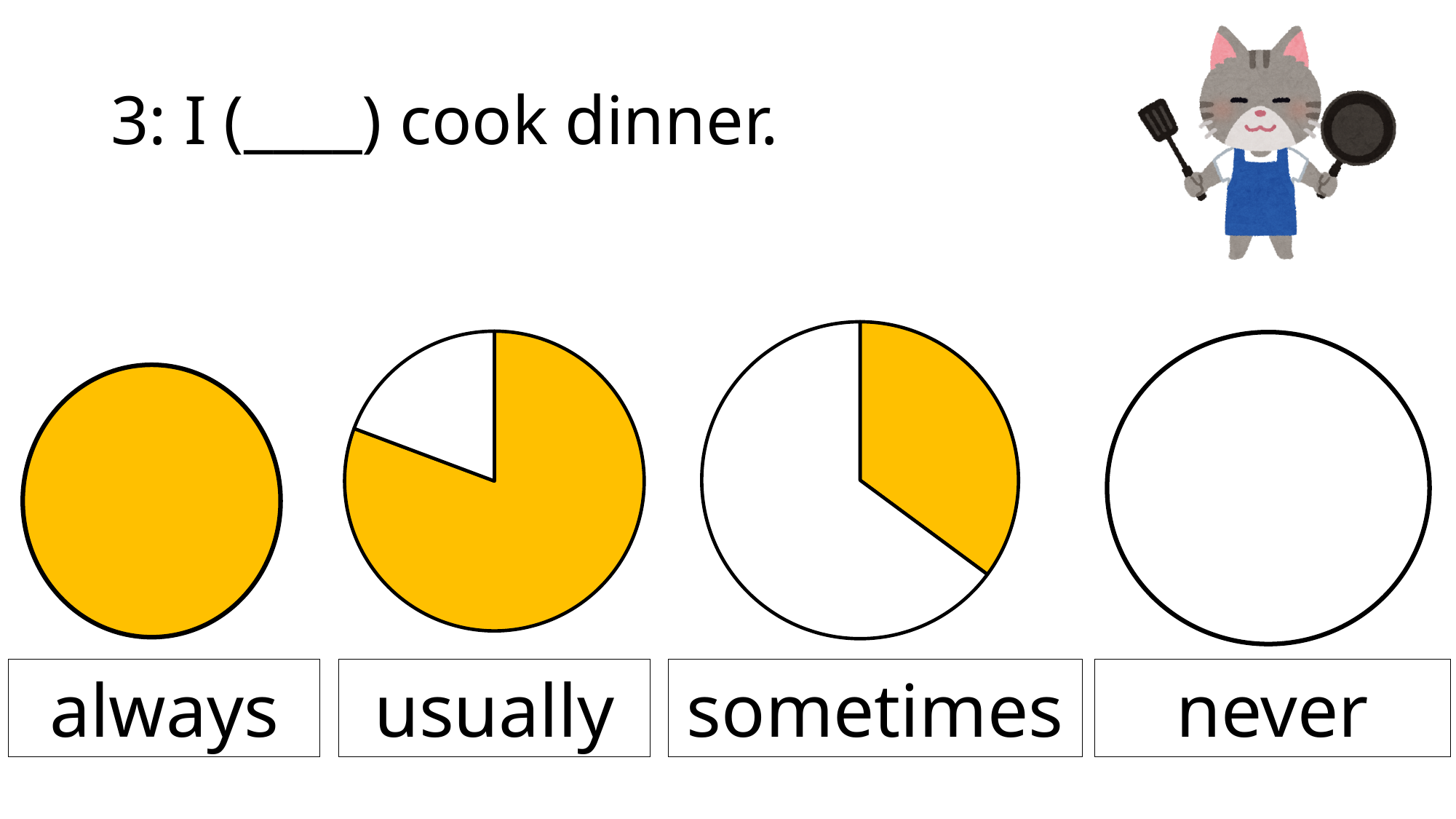
Which chart has a larger yellow share, sometimes or always? always Is the yellow portion of the 'sometimes' chart greater or less than half of the circle? less Which labelled chart has the largest yellow share? always How many pie charts are shown on the slide? 4 What kind of chart is used to show the frequency words on the slide? pie chart What colour is the filled portion of the pie charts? yellow What label appears under the third chart from the left? sometimes Which chart has a larger yellow share, usually or sometimes? usually Moving from the leftmost chart to the rightmost chart, does the yellow share rise or fall? fall Is the yellow portion of the 'usually' chart greater or less than half of the circle? greater Which labelled chart has the smallest yellow share? never Which chart has a larger yellow share, never or sometimes? sometimes